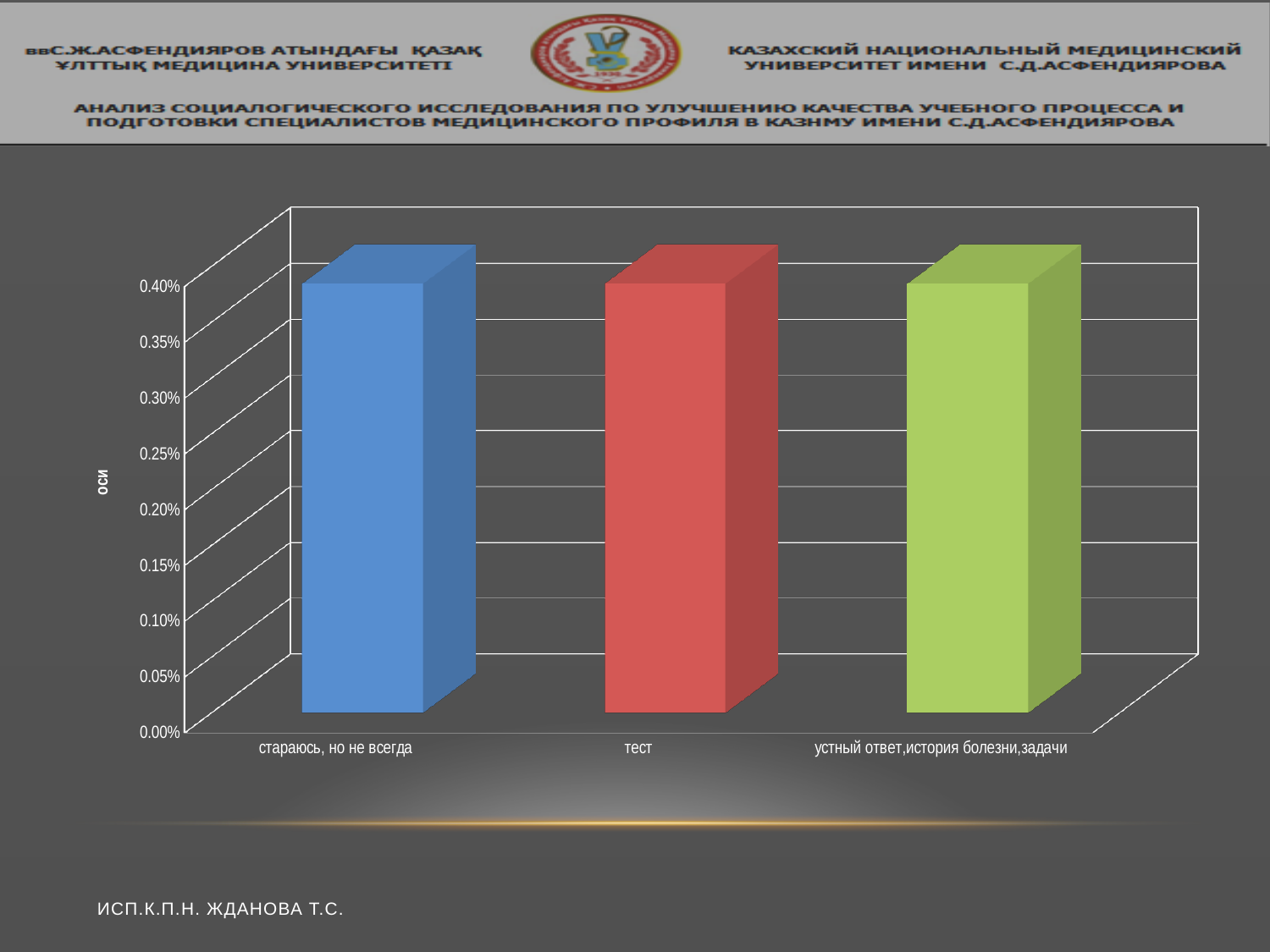
What is the label on the vertical axis of the chart? оси How many categories are shown on the x axis of the chart? 3 Is the value for "устный ответ,история болезни,задачи" greater or less than 0.25%? greater What kind of chart is shown on the slide? bar chart What is the highest tick value shown on the vertical axis? 0.40% Is the value for "стараюсь, но не всегда" greater or less than 0.30%? greater Is the value for "тест" greater or less than 0.10%? greater What colour is the bar for "тест"? red What is the label of the leftmost category on the x axis? стараюсь, но не всегда